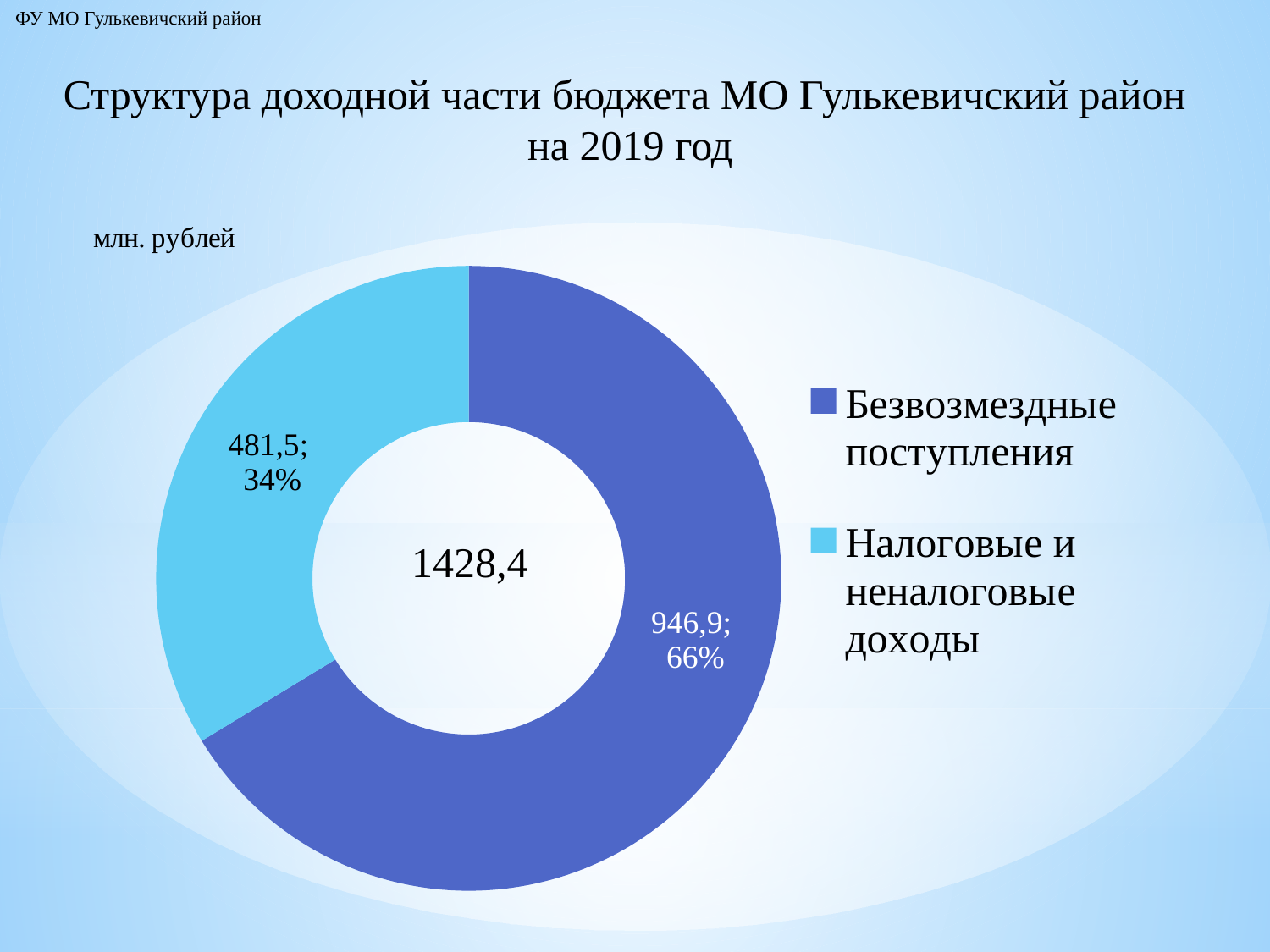
Which category has the smallest value? Налоговые и неналоговые доходы What is the value for Безвозмездные поступления? 946,9 What is the value for Налоговые и неналоговые доходы? 481,5 Which is larger: Безвозмездные поступления or Налоговые и неналоговые доходы? Безвозмездные поступления What unit of measurement is indicated for the chart? млн. рублей What total value is printed in the centre of the chart? 1428,4 What is the difference between the values for Безвозмездные поступления and Налоговые и неналоговые доходы? 465,4 How many categories does the chart show? 2 What share of the chart does Налоговые и неналоговые доходы represent? 34% What share of the chart does Безвозмездные поступления represent? 66% Which category has the largest value? Безвозмездные поступления What kind of chart is shown on the slide? Doughnut (pie) chart